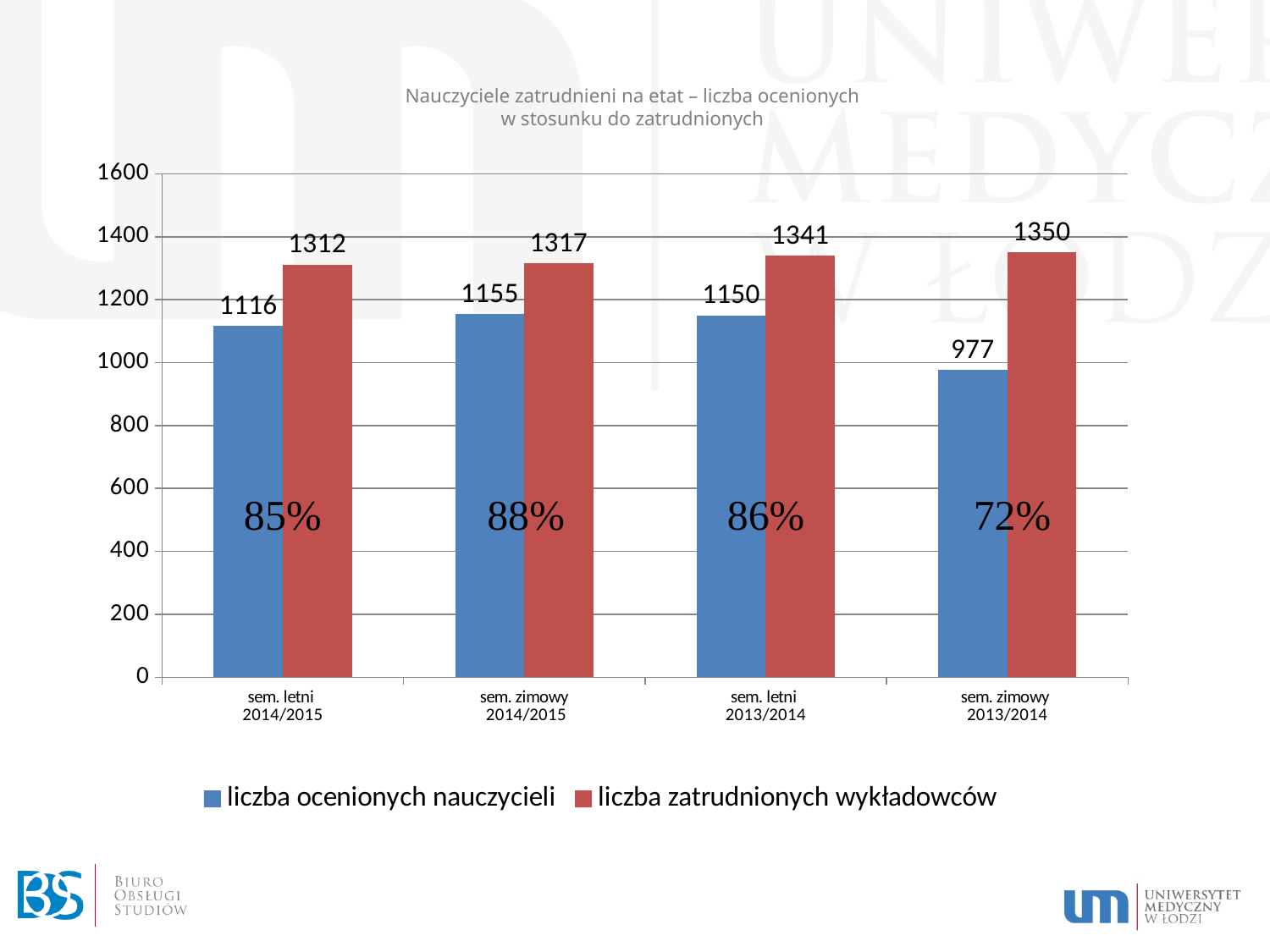
What percentage is shown inside the bars for sem. zimowy 2013/2014? 72% What is the value of 'liczba ocenionych nauczycieli' for sem. zimowy 2014/2015? 1155 What is the value of 'liczba zatrudnionych wykładowców' for sem. zimowy 2013/2014? 1350 Which category has the highest value for 'liczba zatrudnionych wykładowców'? sem. zimowy 2013/2014 Which category has the lowest value for 'liczba ocenionych nauczycieli'? sem. zimowy 2013/2014 Which is larger: 'liczba ocenionych nauczycieli' for sem. zimowy 2014/2015 or for sem. letni 2013/2014? sem. zimowy 2014/2015 What is the difference between 'liczba zatrudnionych wykładowców' and 'liczba ocenionych nauczycieli' for sem. letni 2013/2014? 191 How many categories are shown on the x axis? 4 Is the value for 'liczba ocenionych nauczycieli' for sem. zimowy 2013/2014 greater or less than 1000? less How many series does the legend list? 2 What kind of chart is shown on the slide? bar chart What is the value of 'liczba ocenionych nauczycieli' for sem. letni 2014/2015? 1116